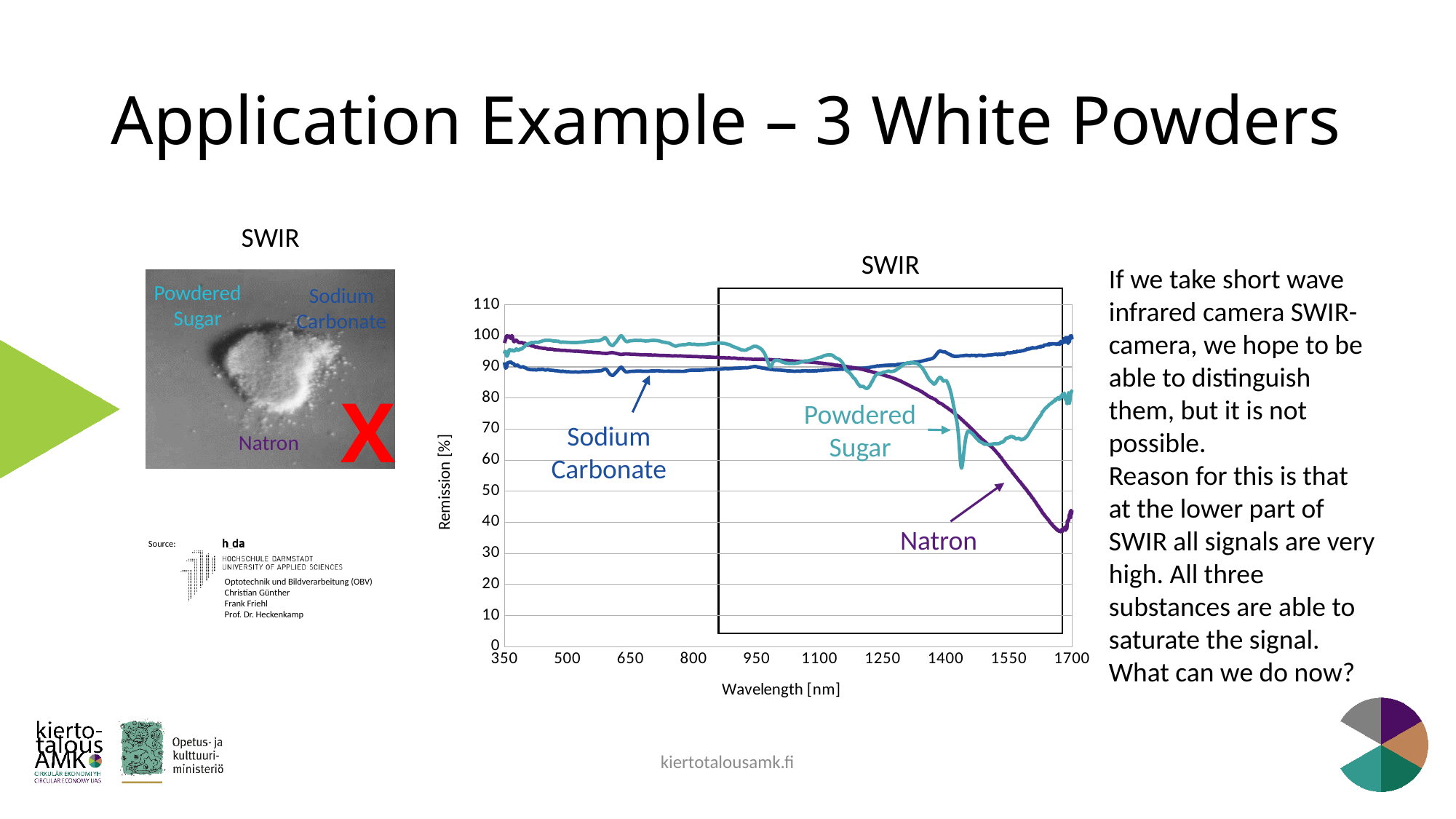
Which substance has the lowest remission at 500 nm? Sodium Carbonate Which substance has the lowest remission at 1700 nm? Natron What is the title of the chart? SWIR Is the value for Natron at 1700 nm greater or less than 50? less At 1550 nm, which is higher, Sodium Carbonate or Natron? Sodium Carbonate How many substances (series) are plotted in the chart? 3 What is the label of the vertical axis of the chart? Remission [%] Is the value for Sodium Carbonate at 1700 nm greater or less than 90? greater Does the Sodium Carbonate curve rise or fall between 1250 nm and 1700 nm? rise Is the lowest value reached by the Powdered Sugar curve greater or less than 70? less What kind of chart is shown on the slide? line chart Does the Natron curve rise or fall as wavelength increases from 350 nm to 1700 nm? fall